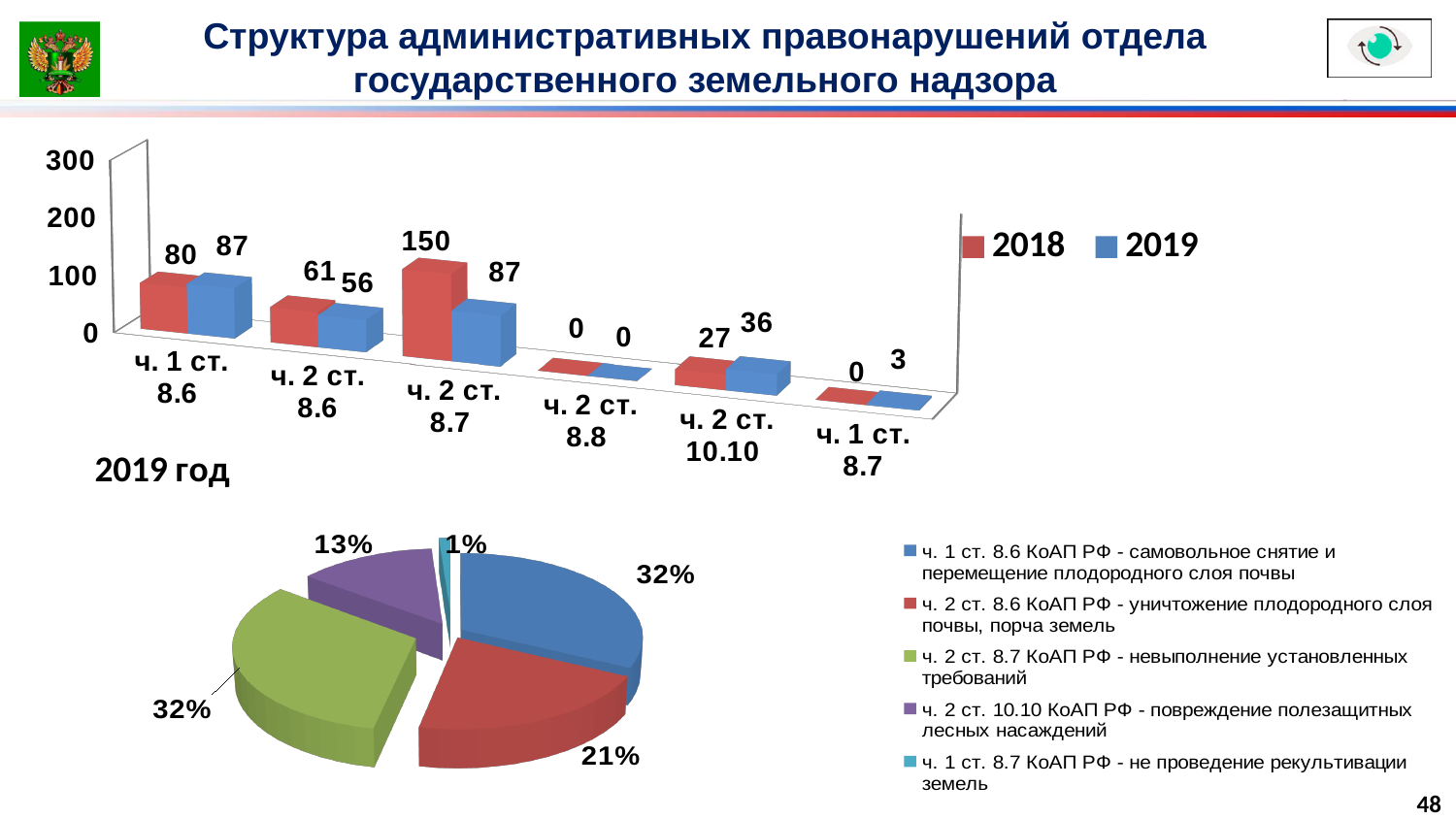
In the top bar chart, what is the 2019 value for ч. 2 ст. 10.10? 36 In the top bar chart, what is the 2019 value for ч. 1 ст. 8.7? 3 What kind of chart is the top chart on the slide? Bar chart In the top bar chart, which category has the highest 2018 value? ч. 2 ст. 8.7 In the bottom pie chart (2019 год), what share does ч. 2 ст. 8.6 КоАП РФ have? 21% How many slices does the bottom pie chart (2019 год) have? 5 In the top bar chart, what is the difference between the 2018 and 2019 values for ч. 2 ст. 8.7? 63 In the top bar chart, what is the 2018 value for ч. 2 ст. 8.7? 150 How many categories are shown on the x axis of the top bar chart? 6 In the top bar chart, which is larger for ч. 2 ст. 8.6: the 2018 value or the 2019 value? 2018 In the bottom pie chart (2019 год), what share does ч. 2 ст. 10.10 КоАП РФ have? 13% How many series does the legend of the top bar chart list? 2